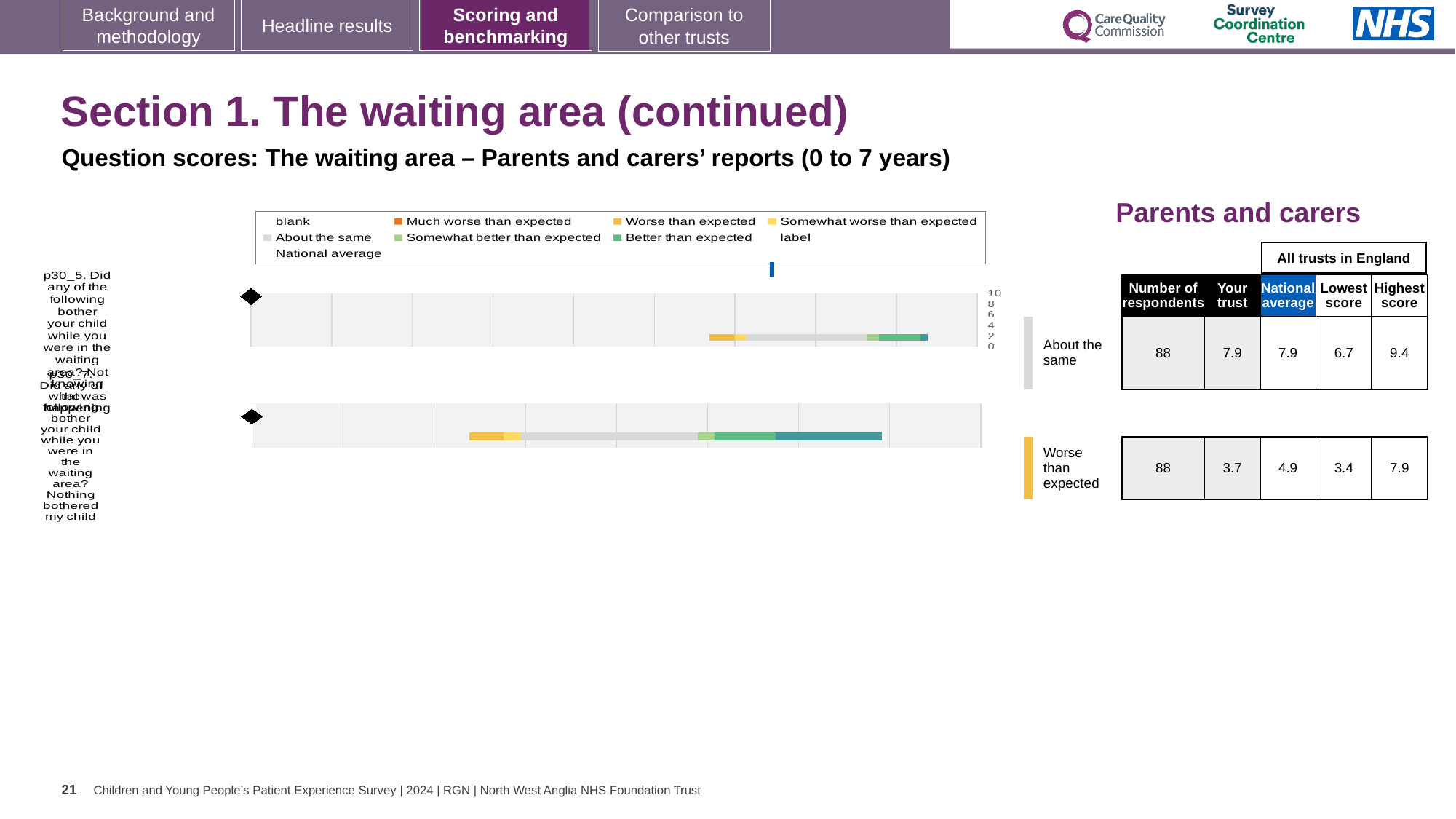
What colour does the legend use for 'Much worse than expected'? orange What kind of chart is shown on the slide? bar chart How many entries does the chart legend list? 9 What is the 'Your trust' score for the 'Worse than expected' row? 3.7 What is the highest score for the 'Worse than expected' row? 7.9 What is the number of respondents for the 'About the same' row? 88 What is the lowest score for the 'About the same' row? 6.7 Which benchmark category is the second question (p30_7) rated as, according to the label beside its bar? Worse than expected For the 'Worse than expected' row, which is larger: the 'Your trust' score or the national average? National average What is the difference between the highest score and the lowest score for the 'About the same' row? 2.7 How many question bars are plotted in the chart? 2 What is the national average for the 'Worse than expected' row? 4.9